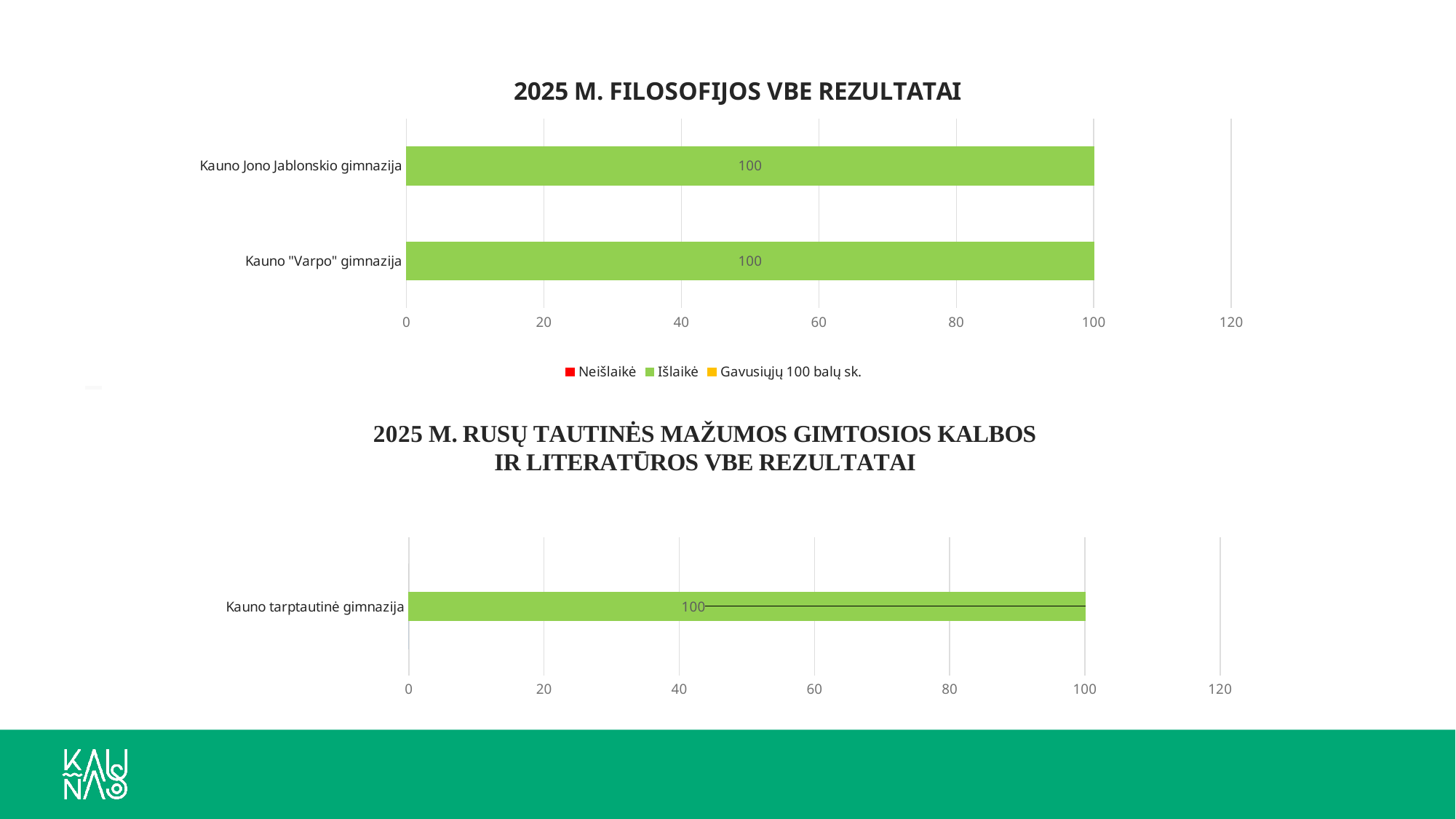
In the bottom chart, "2025 M. RUSŲ TAUTINĖS MAŽUMOS GIMTOSIOS KALBOS IR LITERATŪROS VBE REZULTATAI", is the value for Kauno tarptautinė gimnazija greater or less than 60? greater How many series does the legend of the chart titled "2025 M. FILOSOFIJOS VBE REZULTATAI" list? 3 How many schools are shown in the chart titled "2025 M. FILOSOFIJOS VBE REZULTATAI"? 2 In the chart titled "2025 M. FILOSOFIJOS VBE REZULTATAI", what is the Išlaikė value for Kauno "Varpo" gimnazija? 100 What type of chart is the top chart, "2025 M. FILOSOFIJOS VBE REZULTATAI"? Bar chart In the bottom chart, "2025 M. RUSŲ TAUTINĖS MAŽUMOS GIMTOSIOS KALBOS IR LITERATŪROS VBE REZULTATAI", what is the value for Kauno tarptautinė gimnazija? 100 In the chart titled "2025 M. FILOSOFIJOS VBE REZULTATAI", is the value for Kauno "Varpo" gimnazija greater or less than 80? greater In the chart titled "2025 M. FILOSOFIJOS VBE REZULTATAI", which legend entry is shown in red? Neišlaikė In the chart titled "2025 M. FILOSOFIJOS VBE REZULTATAI", what is the difference between the values for Kauno Jono Jablonskio gimnazija and Kauno "Varpo" gimnazija? 0 In the chart titled "2025 M. FILOSOFIJOS VBE REZULTATAI", what is the Išlaikė value for Kauno Jono Jablonskio gimnazija? 100 How many schools are shown in the bottom chart, "2025 M. RUSŲ TAUTINĖS MAŽUMOS GIMTOSIOS KALBOS IR LITERATŪROS VBE REZULTATAI"? 1 What is the title of the bottom chart on the slide? 2025 M. RUSŲ TAUTINĖS MAŽUMOS GIMTOSIOS KALBOS IR LITERATŪROS VBE REZULTATAI